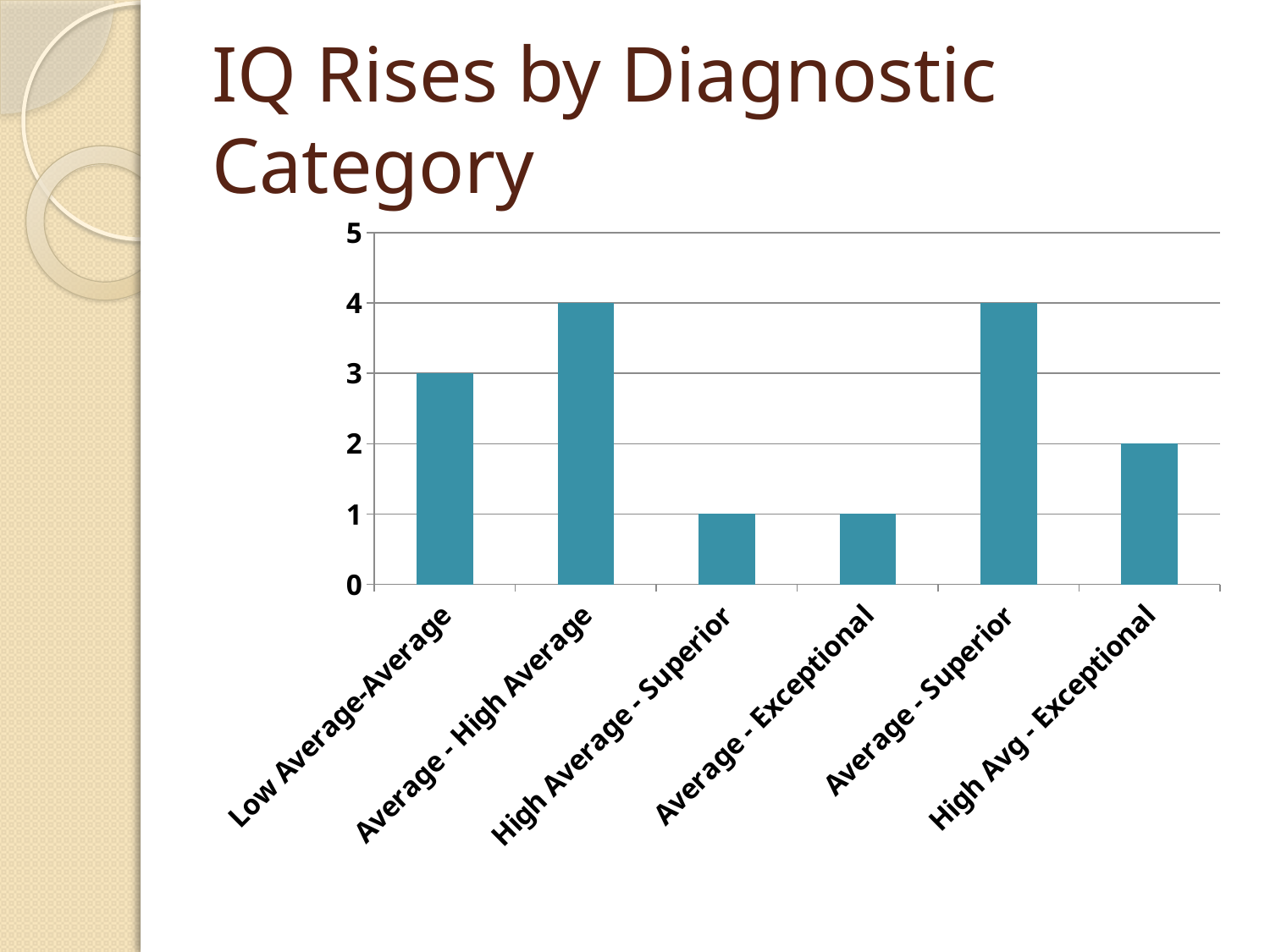
What is the title of the chart on the slide? IQ Rises by Diagnostic Category What is the value for Average - Superior? 4 Is the value for Average - High Average greater or less than 3? greater What is the value for Average - High Average? 4 How many diagnostic categories are shown on the x axis? 6 Which is larger, the value for Low Average-Average or the value for High Avg - Exceptional? Low Average-Average What is the value for Low Average-Average? 3 What type of chart is shown on the slide? Bar chart What is the difference between the values for Average - Superior and Average - Exceptional? 3 What is the value for High Average - Superior? 1 What is the value for High Avg - Exceptional? 2 What is the highest value shown on the vertical axis? 5